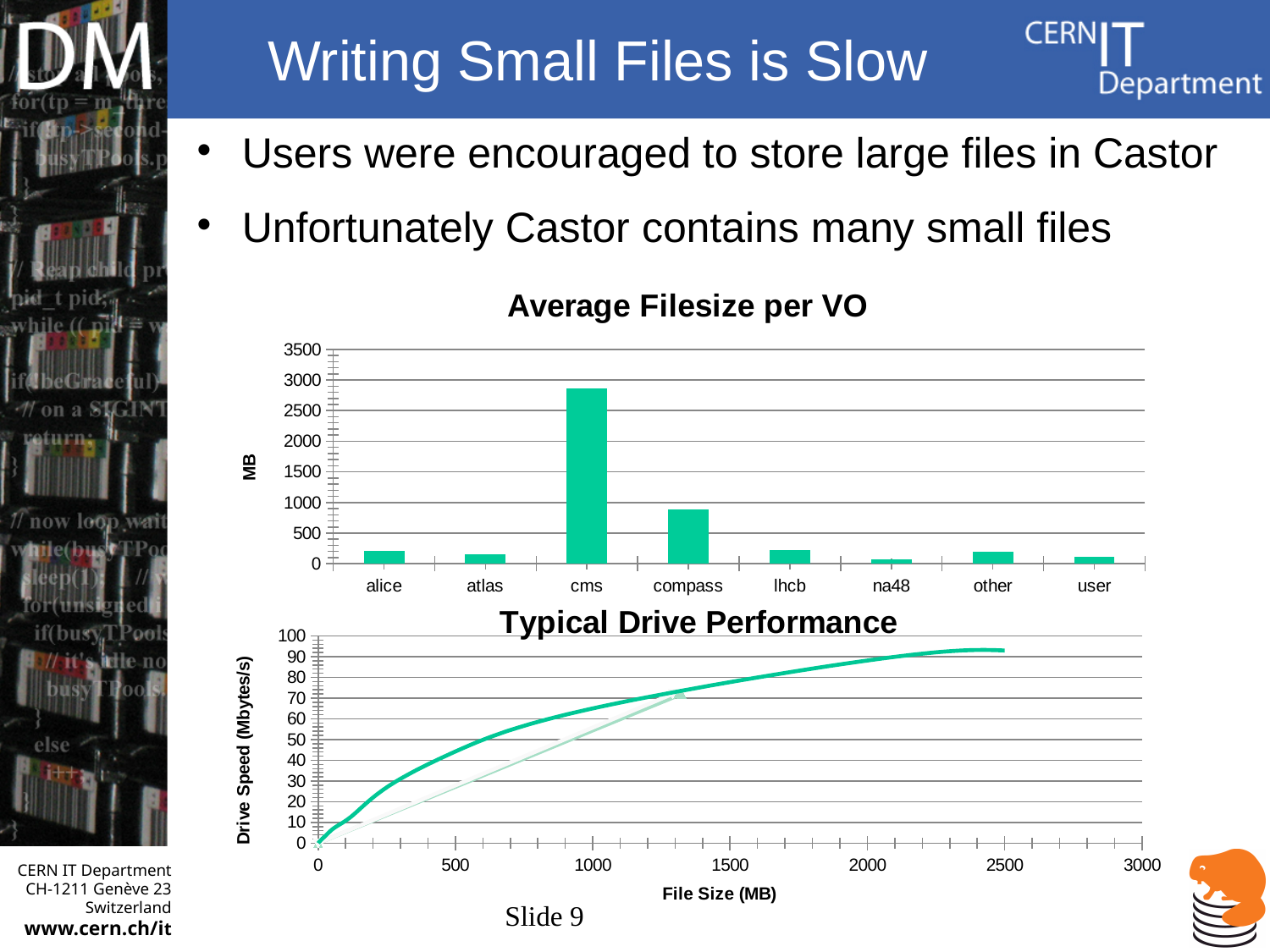
In the 'Typical Drive Performance' chart, what is the label of the y axis? Drive Speed (Mbytes/s) In the 'Average Filesize per VO' chart, which is larger, the value for cms or the value for compass? cms In the 'Typical Drive Performance' chart, does drive speed rise or fall as file size increases? rise What kind of chart is the 'Typical Drive Performance' chart? line chart In the 'Average Filesize per VO' chart, how many VO categories are shown on the x axis? 8 In the 'Average Filesize per VO' chart, which VO has the highest average filesize? cms In the 'Average Filesize per VO' chart, is the value for compass greater or less than 1000? less In the 'Average Filesize per VO' chart, is the value for compass greater or less than 500? greater In the 'Typical Drive Performance' chart, what is the label of the x axis? File Size (MB) What kind of chart is the 'Average Filesize per VO' chart? bar chart In the 'Average Filesize per VO' chart, is the value for cms greater or less than 2500? greater